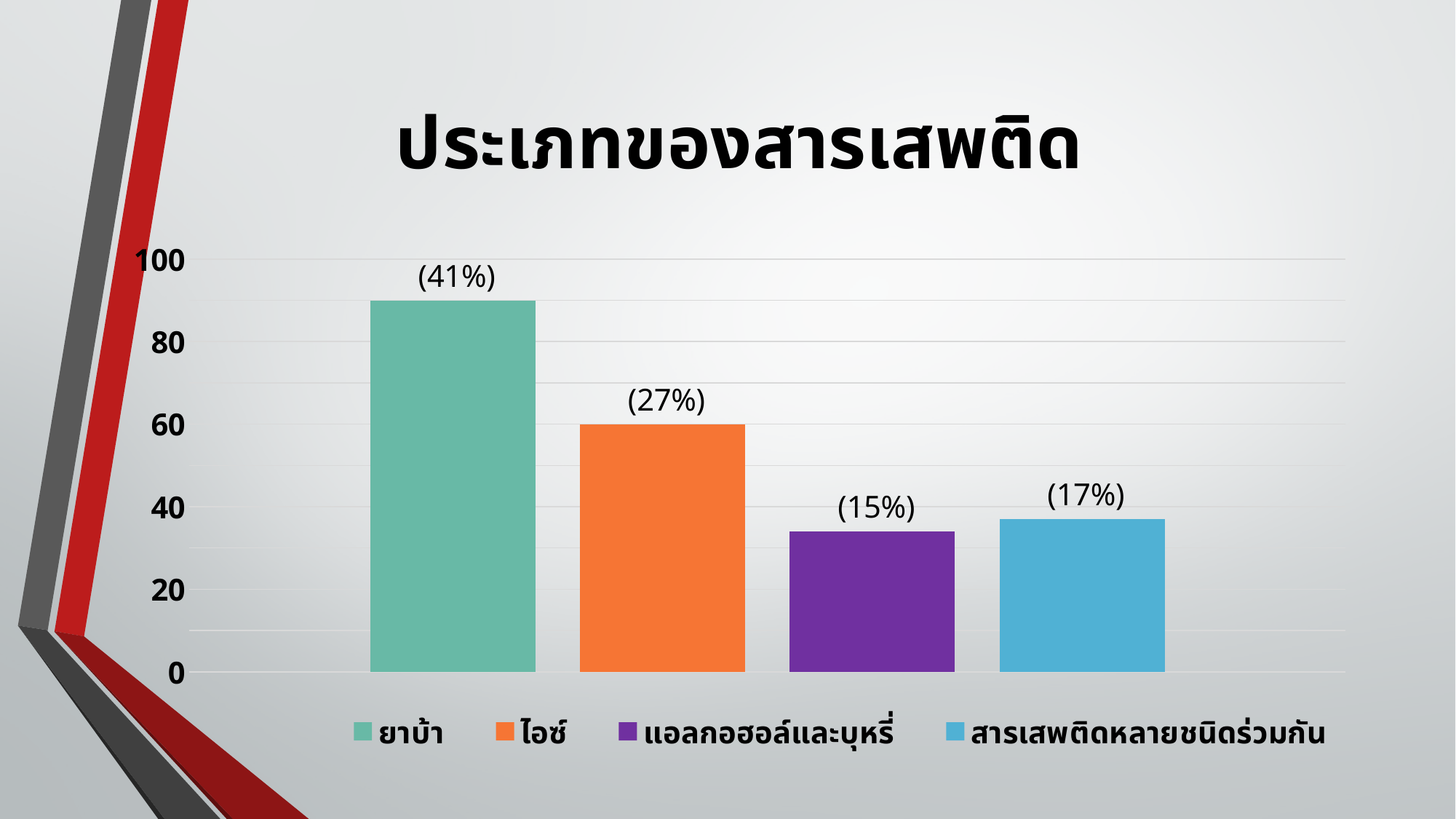
What percentage is labelled on the bar for สารเสพติดหลายชนิดร่วมกัน? 17% Which category has the highest bar? ยาบ้า What percentage is labelled on the bar for ไอซ์? 27% What percentage is labelled on the bar for ยาบ้า? 41% How many entries does the legend list? 4 What is the title of the chart? ประเภทของสารเสพติด What percentage is labelled on the bar for แอลกอฮอล์และบุหรี่? 15% Which category has the lowest bar? แอลกอฮอล์และบุหรี่ What type of chart is shown on the slide? bar chart What is the difference in percentage points between the labels for ยาบ้า and ไอซ์? 14 Which has the larger labelled percentage, แอลกอฮอล์และบุหรี่ or สารเสพติดหลายชนิดร่วมกัน? สารเสพติดหลายชนิดร่วมกัน Is the bar for ยาบ้า greater or less than 80 on the y axis? greater